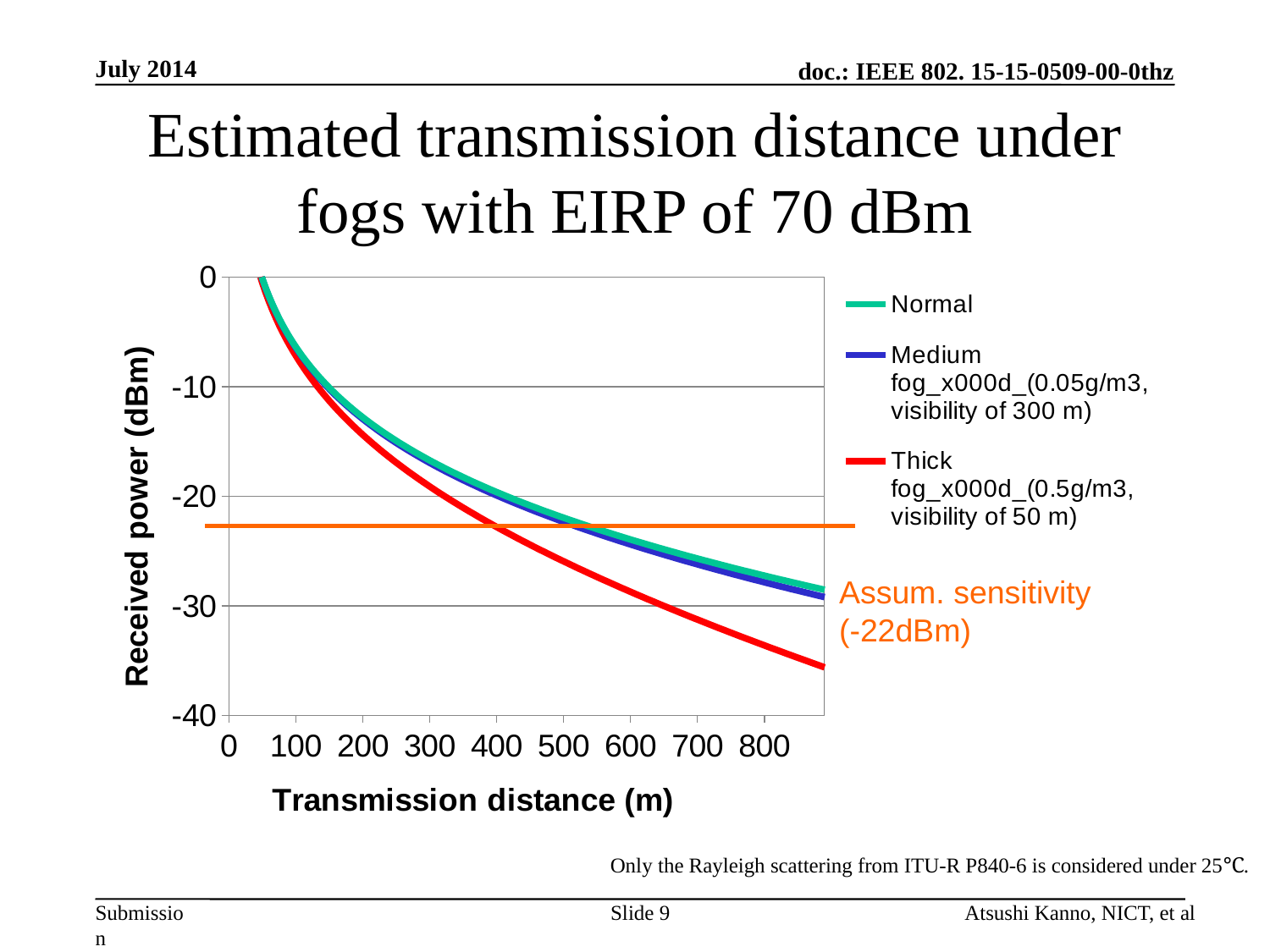
What assumed sensitivity value is marked by the orange horizontal line? -22dBm What kind of chart is shown on the slide? line chart Do the received power values rise or fall as transmission distance increases? fall Which series has the lowest received power at 700 m? Thick fog Is the received power for Normal at 800 m greater or less than -30? greater Is the received power for Thick fog at 800 m greater or less than -30? less At 800 m, which series has the higher received power, Normal or Thick fog? Normal What is the label of the y axis? Received power (dBm) Is the received power for Thick fog at 600 m greater or less than -20? less How many series does the chart legend list? 3 What is the title of the chart on the slide? Estimated transmission distance under fogs with EIRP of 70 dBm